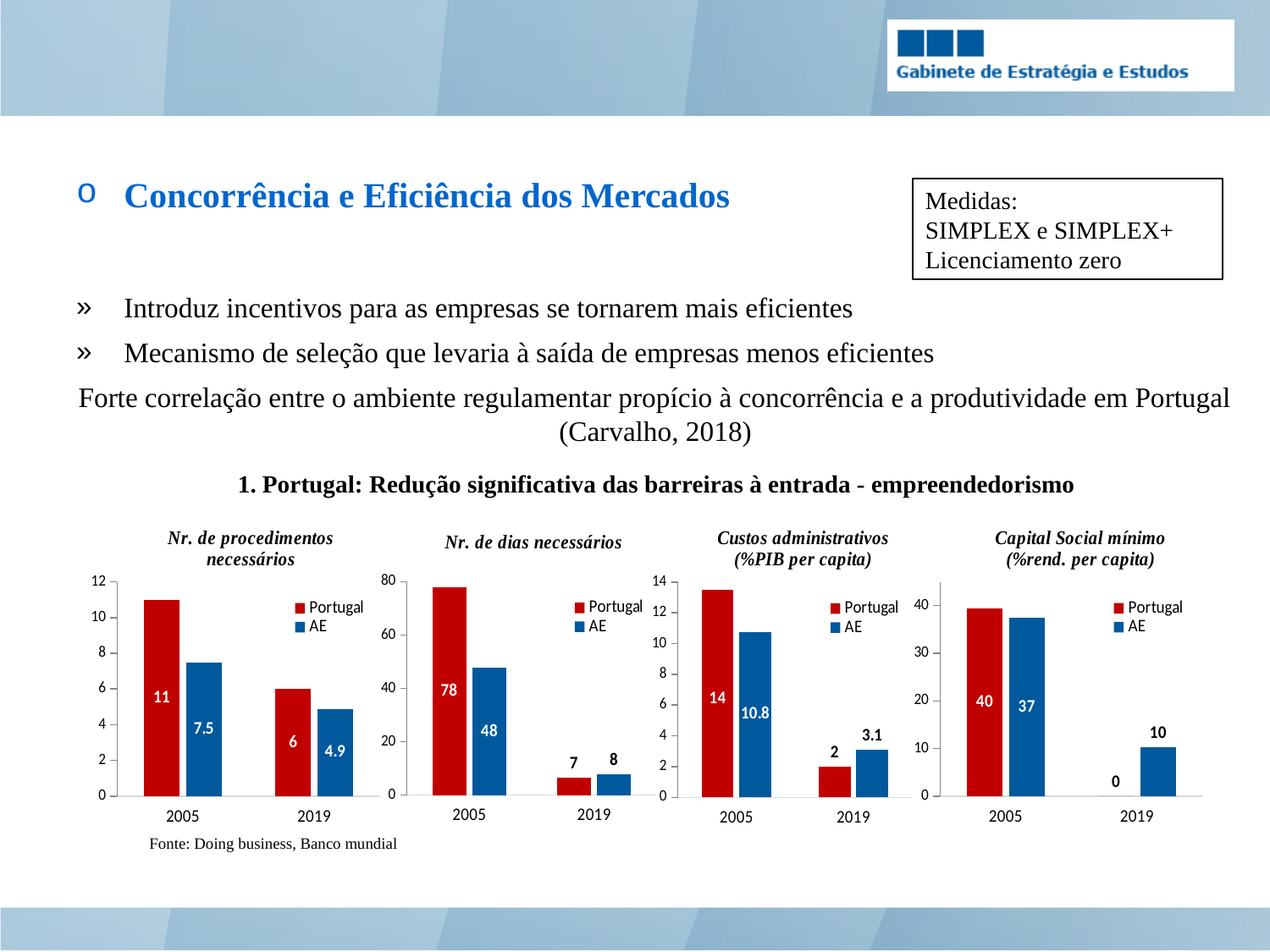
In the 'Capital Social mínimo (%rend. per capita)' chart, what is the difference between Portugal and AE in 2005? 3 In the 'Capital Social mínimo (%rend. per capita)' chart, what is the value for AE in 2019? 10 In the 'Nr. de dias necessários' chart, what is the difference between Portugal and AE in 2005? 30 In the 'Nr. de dias necessários' chart, which is larger in 2019, Portugal or AE? AE In the 'Custos administrativos (%PIB per capita)' chart, what is the value for AE in 2005? 10.8 In the 'Nr. de dias necessários' chart, what is the value for Portugal in 2005? 78 In the 'Nr. de procedimentos necessários' chart, what is the value for AE in 2019? 4.9 In the 'Nr. de procedimentos necessários' chart, what is the value for Portugal in 2005? 11 How many series does the legend of the 'Nr. de dias necessários' chart list? 2 In the 'Capital Social mínimo (%rend. per capita)' chart, what is the value for Portugal in 2019? 0 What kind of chart is the 'Custos administrativos (%PIB per capita)' chart? Bar chart In the 'Custos administrativos (%PIB per capita)' chart, what is the value for Portugal in 2019? 2